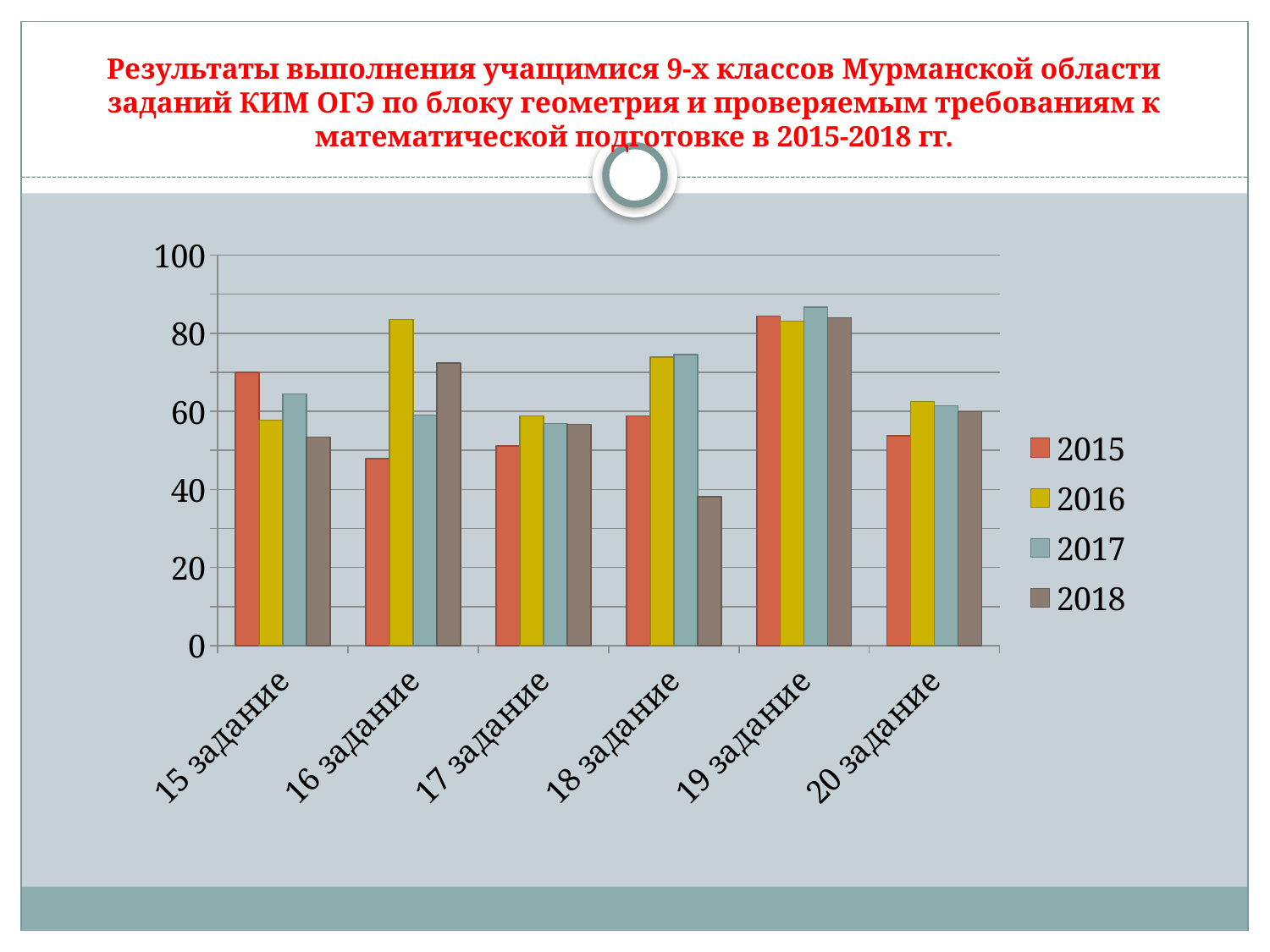
What kind of chart is shown on the slide? bar chart For 15 задание, which is larger: the value for 2015 or for 2018? 2015 Is the value for 2016 in 16 задание greater or less than 80? greater How many series does the legend list? 4 Is the value for 2018 in 18 задание greater or less than 40? less Which year has the lowest bar for 18 задание? 2018 Which task has the lowest bar for 2018? 18 задание Is the value for 2015 in 15 задание greater or less than 60? greater How many task categories are shown on the x axis? 6 Which colour represents the 2016 series in the legend? yellow Which year has the highest bar for 16 задание? 2016